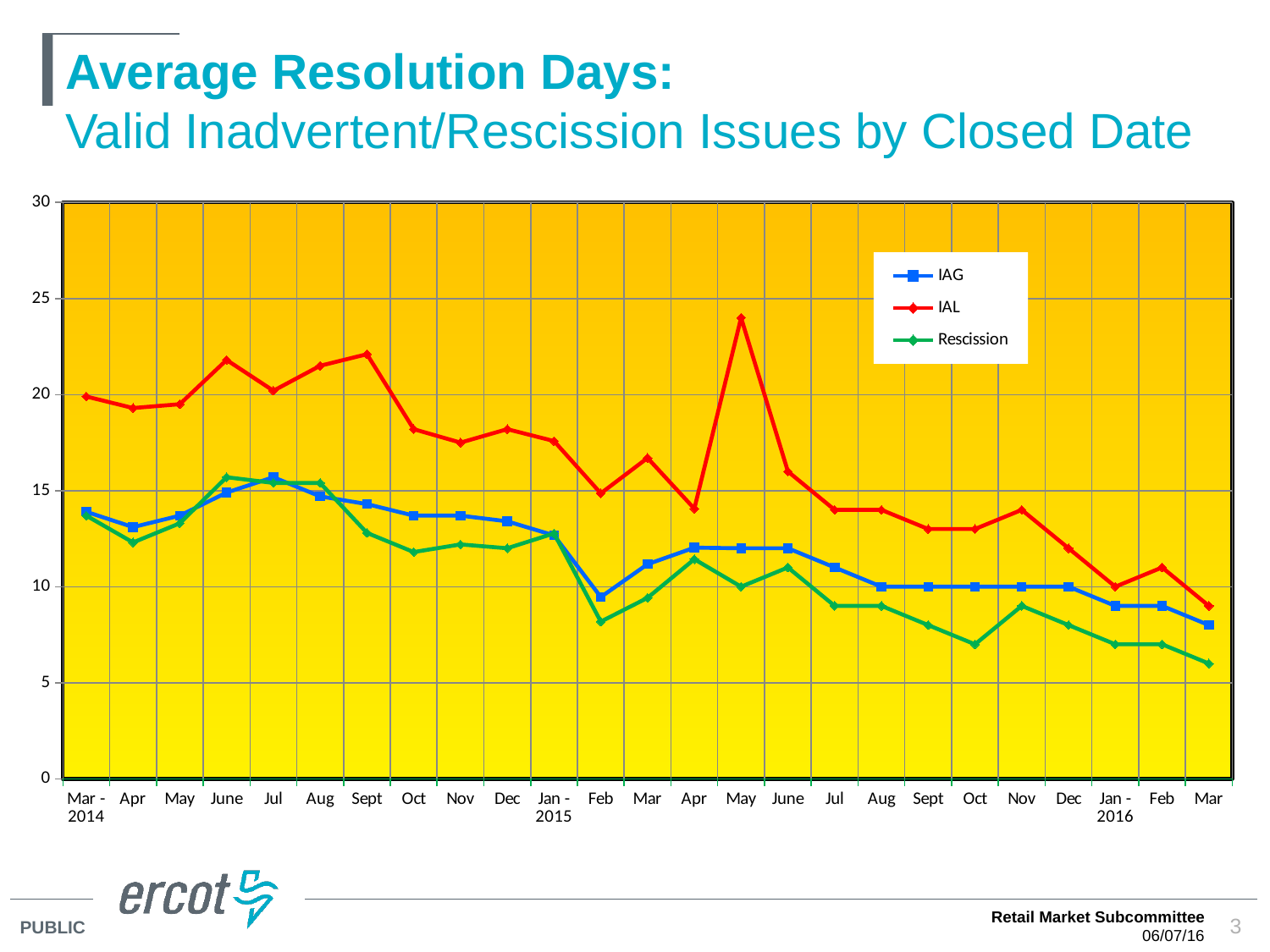
In which month does the IAL series reach its highest value? May 2015 Is the IAL value for Sept 2014 greater or less than 20? greater Is the Rescission value for Feb 2015 greater or less than 10? less Which series has the highest values across the whole period? IAL Overall, do the IAG values rise or fall from Mar 2014 to Mar 2016? fall What kind of chart is shown on the slide? line chart How many series does the legend list? 3 How many monthly points are plotted along the x axis? 25 Is the Rescission value for Mar 2016 greater or less than 10? less Which series is larger in May 2015, IAL or IAG? IAL What colour is the line for the Rescission series? green